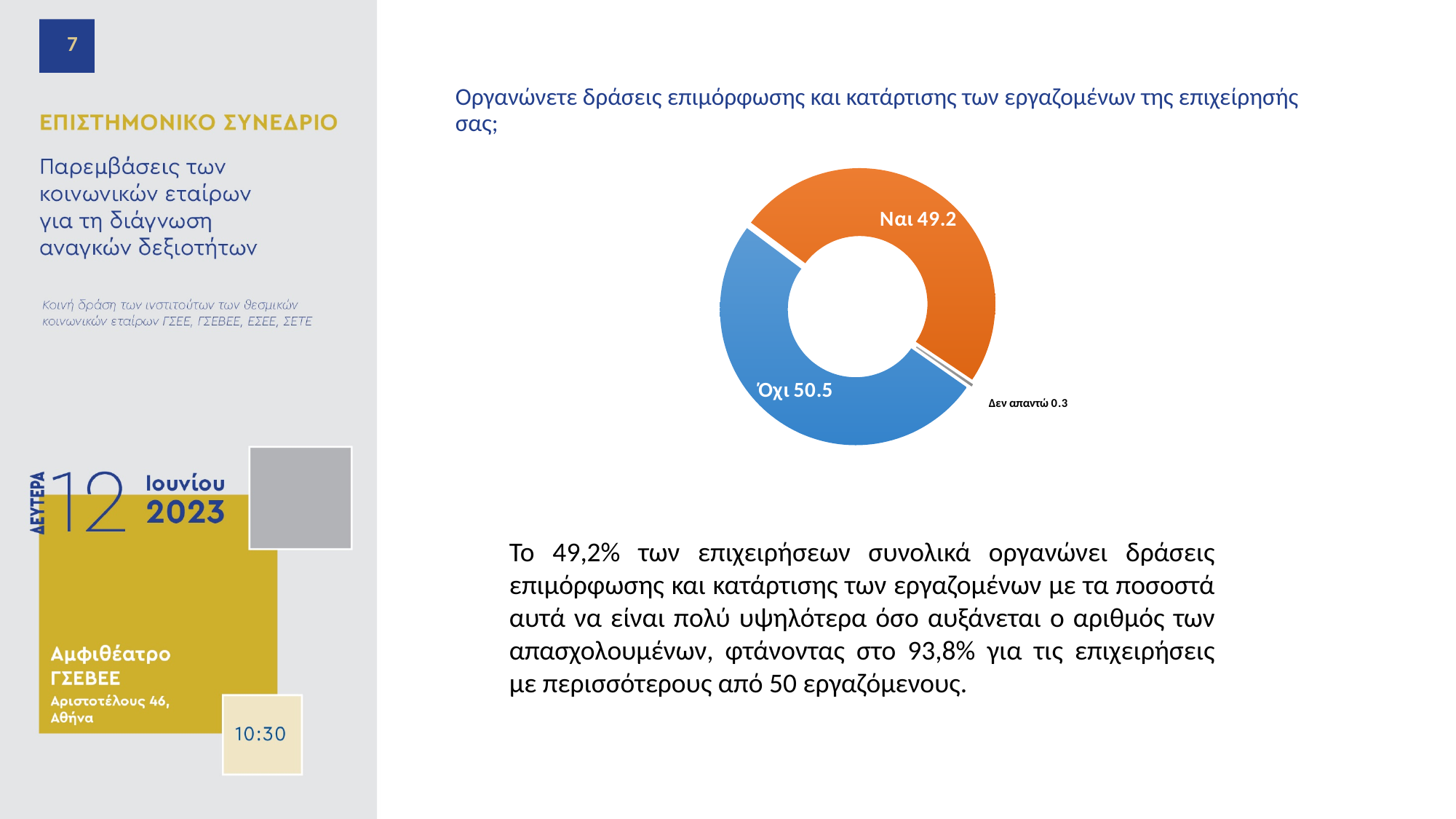
What is the total of the three slice values? 100 What value is shown for the "Ναι" slice? 49.2 Which slice has the smallest value? Δεν απαντώ What value is shown for the "Δεν απαντώ" slice? 0.3 What colour is the "Όχι" slice? blue What is the difference between the "Ναι" and "Δεν απαντώ" values? 48.9 How many slices does the chart have? 3 What kind of chart is shown on the slide? doughnut chart What is the difference between the "Όχι" and "Ναι" values? 1.3 Which slice has the largest value? Όχι Which is larger, the value for "Ναι" or the value for "Δεν απαντώ"? Ναι What value is shown for the "Όχι" slice? 50.5